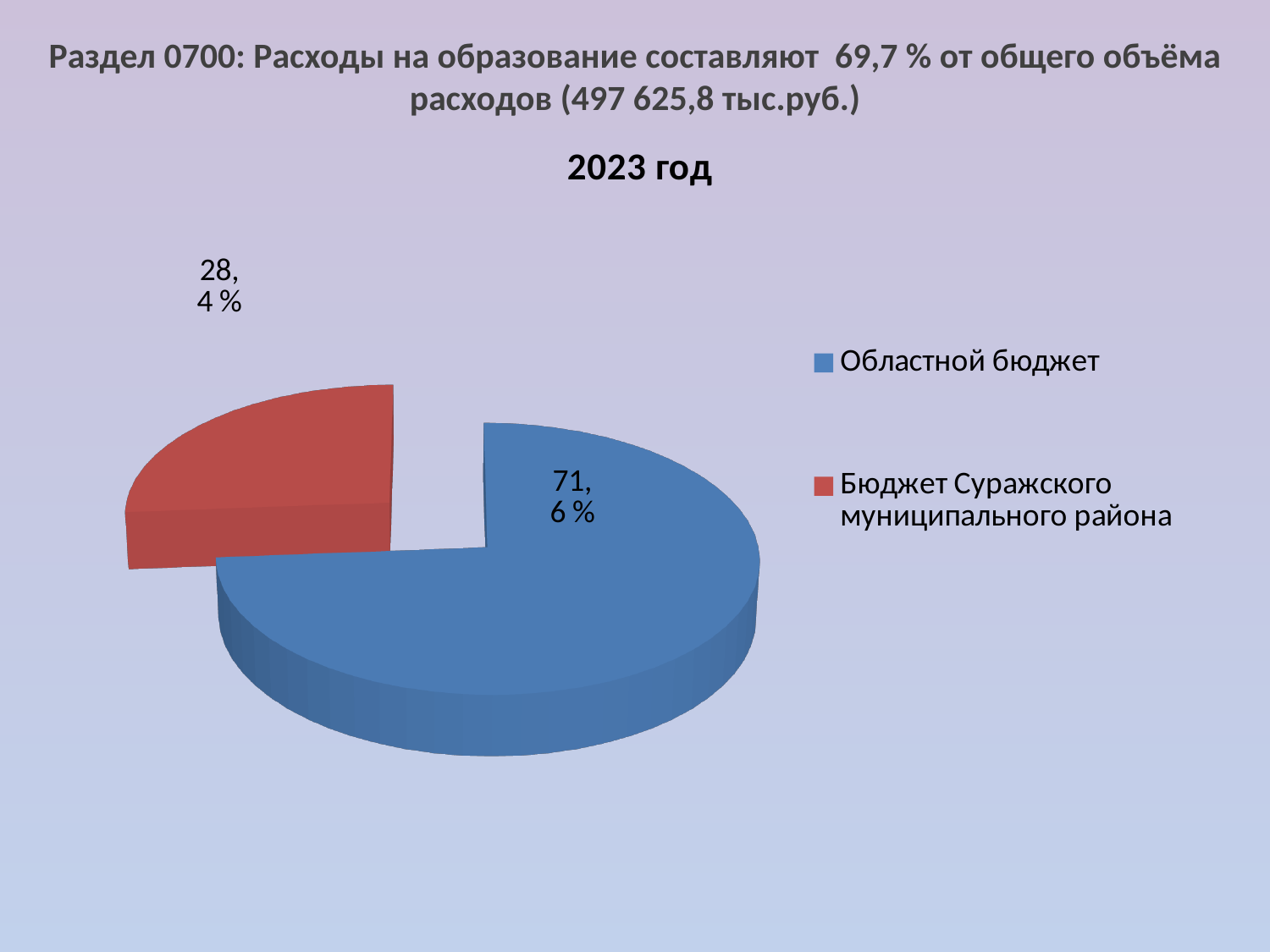
How many entries does the legend list? 2 What is the title of the chart? 2023 год Which is larger: the share of Областной бюджет or the share of Бюджет Суражского муниципального района? Областной бюджет How many slices does the pie chart have? 2 Which category has the smallest slice of the pie? Бюджет Суражского муниципального района What is the difference between the share of Областной бюджет and the share of Бюджет Суражского муниципального района? 43,2 % What share of the pie does Областной бюджет represent? 71,6 % Which category has the largest slice of the pie? Областной бюджет What is the value shown for Бюджет Суражского муниципального района? 28,4 % What colour is the slice for Бюджет Суражского муниципального района? Red What is the value shown for Областной бюджет? 71,6 % What type of chart is shown on the slide? Pie chart